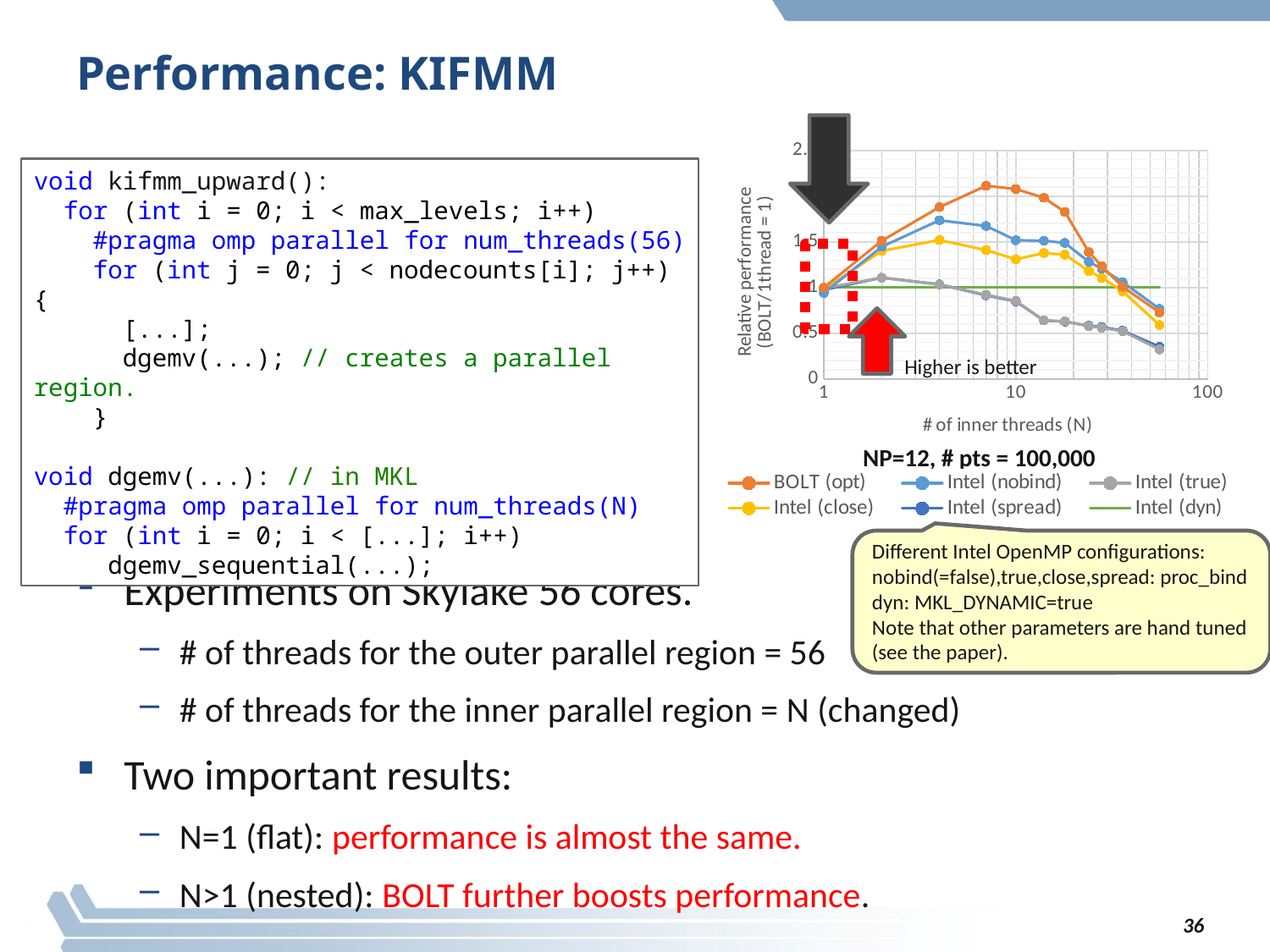
Is the peak value of the Intel (true) series greater or less than 1.5? less Is the value of the Intel (spread) series at the largest number of inner threads greater or less than 0.5? less Which series reaches the highest relative performance on the chart? BOLT (opt) Does the Intel (dyn) series rise, fall, or stay flat as the number of inner threads increases? stay flat Is the value of the Intel (true) series at the largest number of inner threads greater or less than 0.5? less What is the title shown above the chart's legend? NP=12, # pts = 100,000 What kind of chart is shown on the slide? line chart How many series does the chart's legend list? 6 Does the Intel (true) series rise or fall as the number of inner threads increases beyond 2? fall At around 10 inner threads, which series has the larger value: BOLT (opt) or Intel (true)? BOLT (opt) What is the label of the chart's x axis? # of inner threads (N)